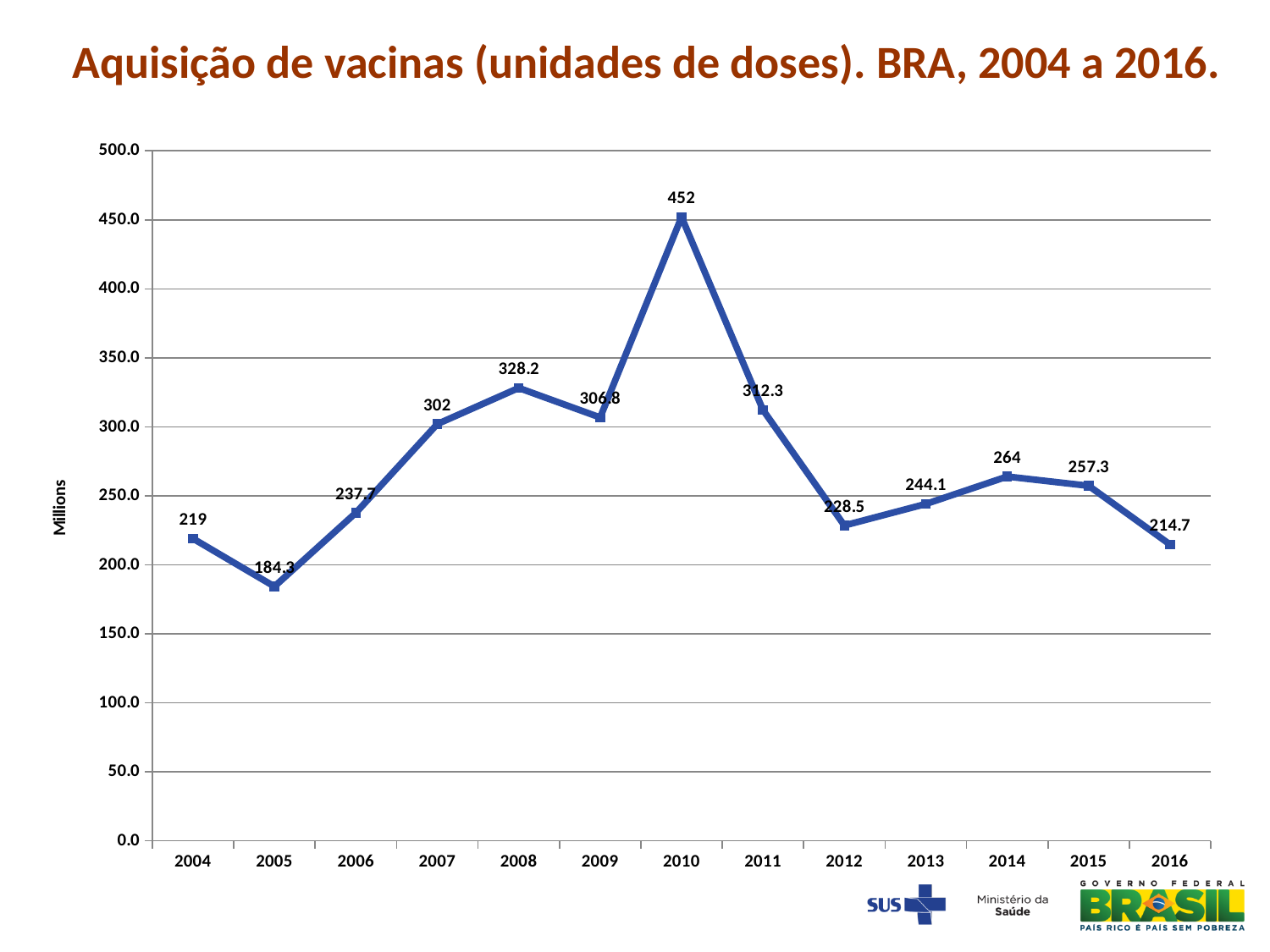
Do the values rise or fall from 2010 to 2012? fall What is the value for 2005? 184.3 Which year has the highest value? 2010 Is the value for 2014 greater or less than 250.0? greater What is the label on the vertical axis? Millions What kind of chart is shown on the slide? line chart What is the difference between the values for 2010 and 2011? 139.7 How many years are plotted on the x axis? 13 What is the value for 2010? 452 Which year has the lowest value? 2005 What is the value for 2016? 214.7 Which is larger, the value for 2008 or the value for 2009? 2008